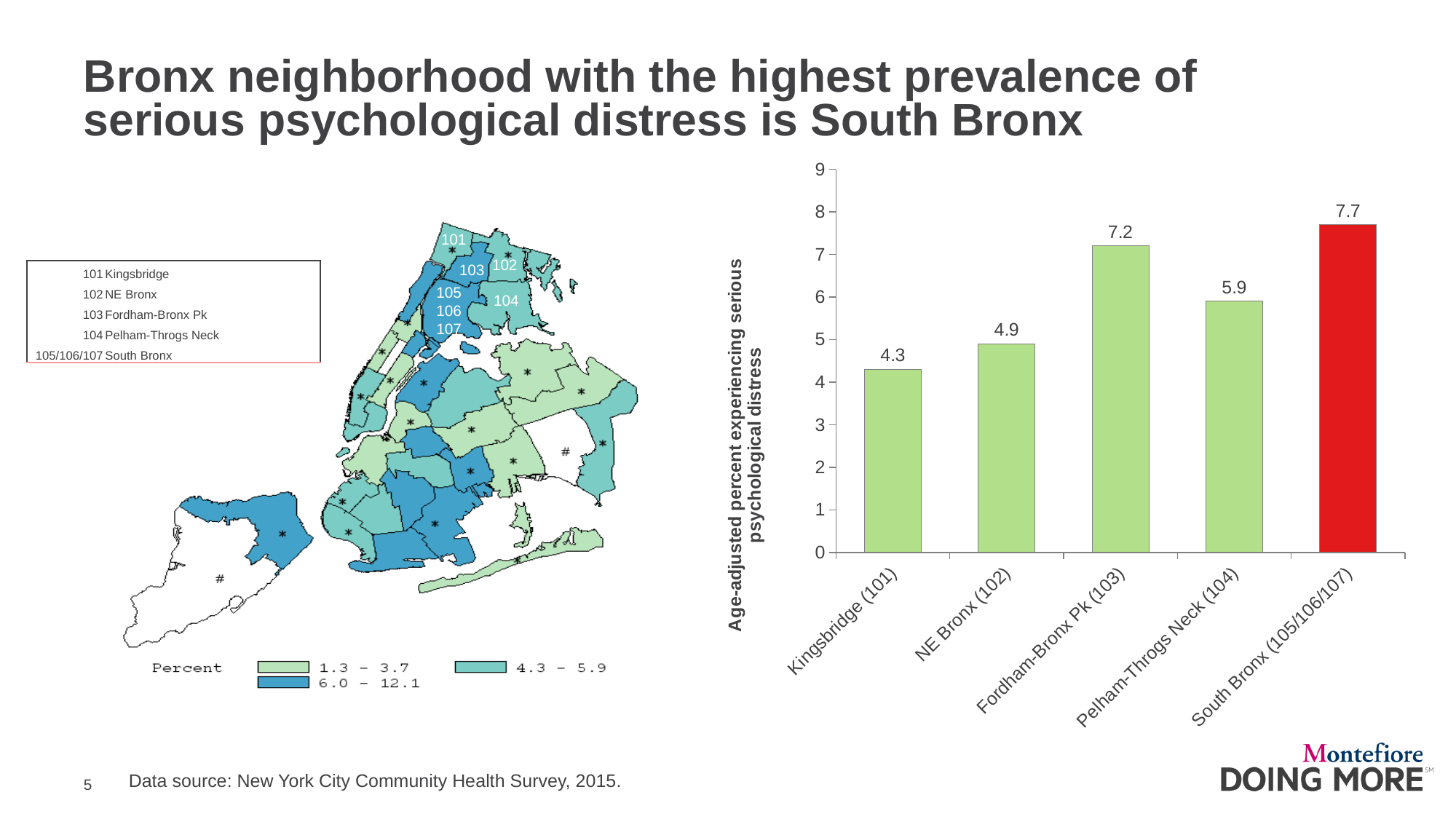
Is the value for NE Bronx (102) greater or less than 6? less What is the value shown for Fordham-Bronx Pk (103)? 7.2 How many neighborhoods are shown in the bar chart? 5 Which neighborhood has the highest age-adjusted percent experiencing serious psychological distress? South Bronx (105/106/107) Which has a higher value, NE Bronx (102) or Pelham-Throgs Neck (104)? Pelham-Throgs Neck (104) What is the difference between the values for Fordham-Bronx Pk (103) and Pelham-Throgs Neck (104)? 1.3 Which neighborhood has the lowest age-adjusted percent experiencing serious psychological distress? Kingsbridge (101) What is the age-adjusted percent experiencing serious psychological distress for South Bronx (105/106/107)? 7.7 Which bar in the chart is colored red rather than green? South Bronx (105/106/107) What is the difference between the values for South Bronx (105/106/107) and Kingsbridge (101)? 3.4 What is the value shown for Kingsbridge (101)? 4.3 What kind of chart is used to show the age-adjusted percent by neighborhood? bar chart